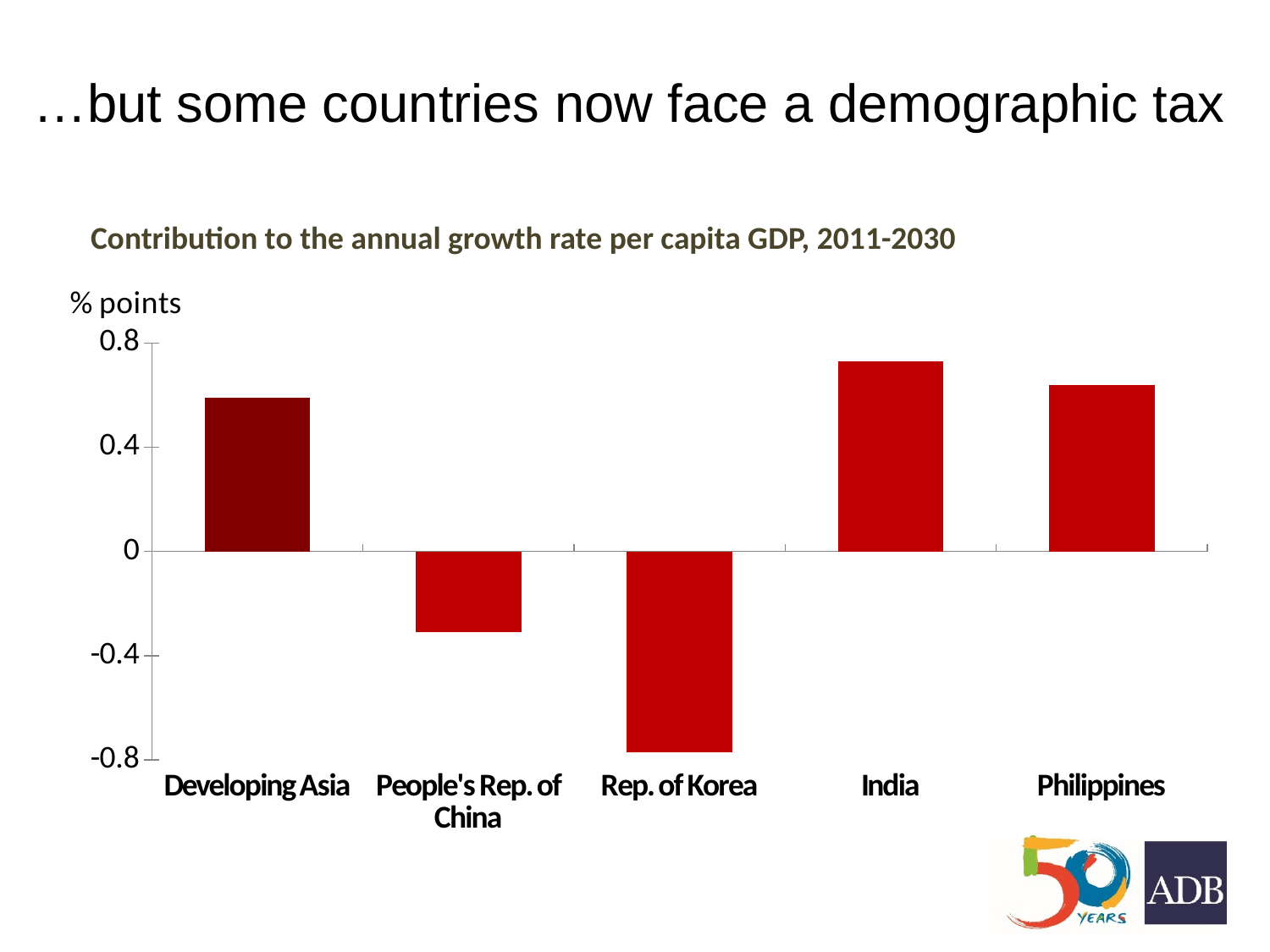
Which has the larger value, India or Philippines? India Which category has the highest value in the chart? India Is the value for People's Rep. of China greater or less than -0.4? greater Which category has the lowest value in the chart? Rep. of Korea Which has the larger value, People's Rep. of China or Rep. of Korea? People's Rep. of China What kind of chart is shown on the slide? bar chart How many categories in the chart have negative values? 2 Is the value for Rep. of Korea greater or less than -0.4? less How many categories are shown on the x axis of the chart? 5 Is the value for Developing Asia greater or less than 0.4? greater What is the title of the chart? Contribution to the annual growth rate per capita GDP, 2011-2030